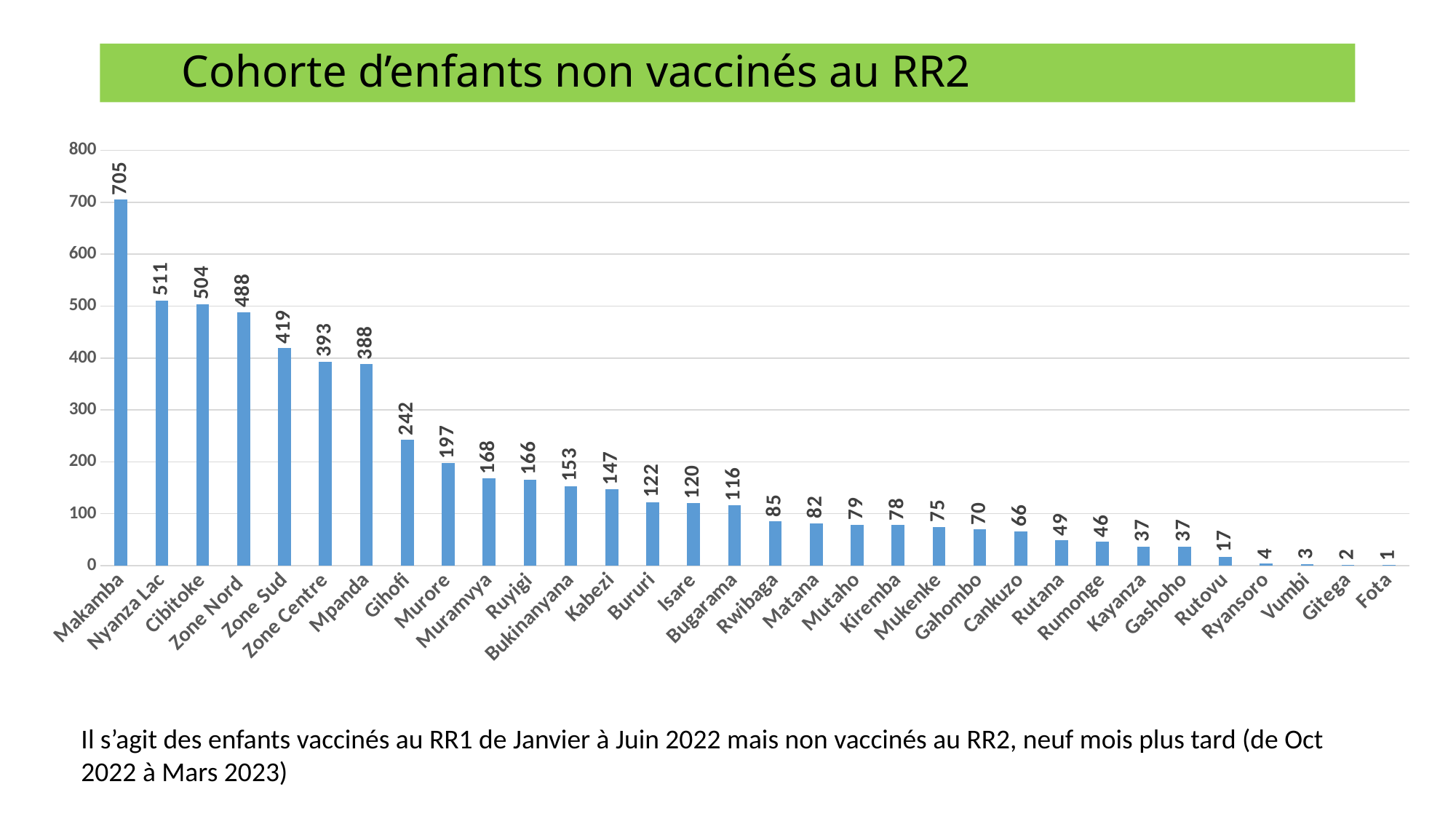
How many categories are shown on the x axis? 32 What is the difference between the values for Makamba and Zone Nord? 217 What is the value for Rumonge? 46 What is the value for Makamba? 705 Which category has the lowest value? Fota Which category has the highest value? Makamba Which is larger, the value for Zone Sud or the value for Mpanda? Zone Sud Do the values rise or fall from left to right along the x axis? fall Is the value for Murore greater or less than 100? greater What is the difference between the values for Nyanza Lac and Cibitoke? 7 What kind of chart is shown on the slide? bar chart What is the value for Gihofi? 242